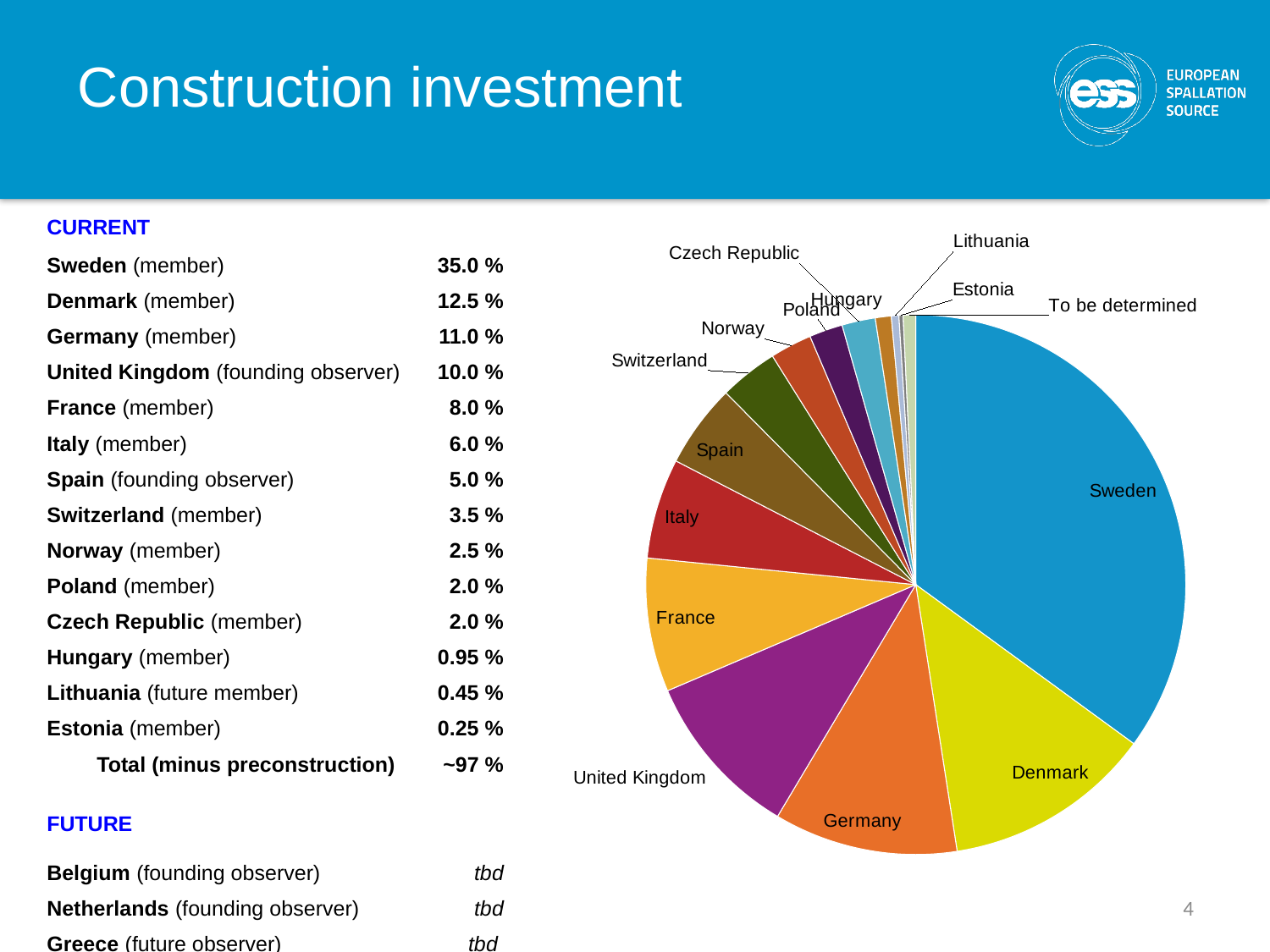
How many slices does the pie chart have? 15 What share of construction investment does Denmark hold? 12.5 % What share of construction investment does Sweden hold? 35.0 % What is the difference between Sweden's share and Denmark's share? 22.5 % Which country has the largest slice of the pie chart? Sweden What share of construction investment does Switzerland hold? 3.5 % What is the difference between France's share and Italy's share? 2.0 % What kind of chart is shown on the slide? pie chart Which slice is larger, Italy or Spain? Italy What share of construction investment does the United Kingdom hold? 10.0 % Which slice is larger, Germany or France? Germany What is the title of the slide containing the pie chart? Construction investment